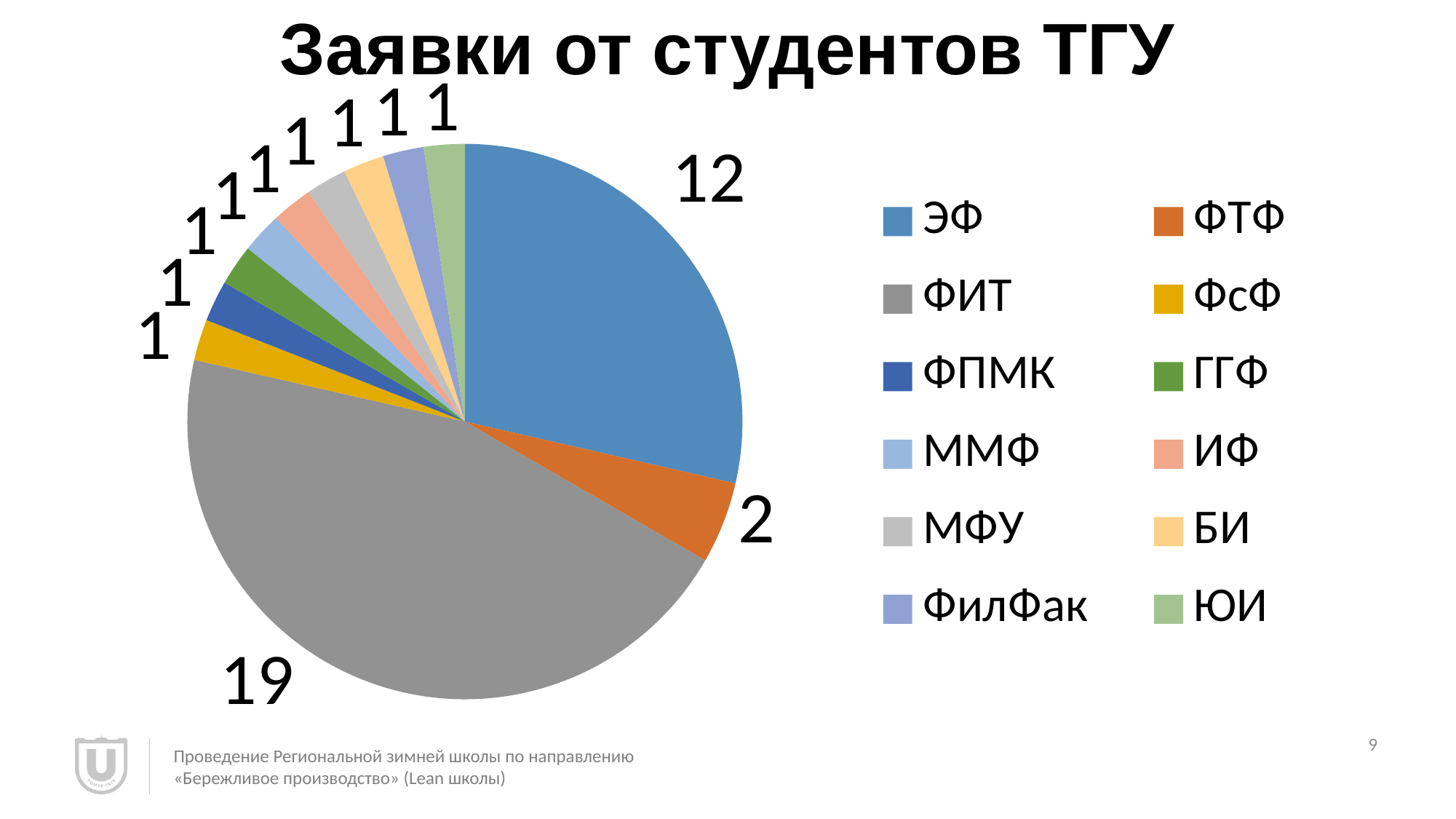
How many applications are shown for ЭФ? 12 Which faculty has the largest slice of the pie? ФИТ How much larger is the value for ЭФ than the value for ФТФ? 10 What value is shown for ФТФ? 2 What is the total of all the values shown on the pie chart? 42 What is the title of the chart? Заявки от студентов ТГУ What value is shown for ГГФ? 1 What is the difference between the values for ФИТ and ЭФ? 7 What value is shown for the ФИТ slice? 19 How many categories does the legend list? 12 Which is larger, the value for ЭФ or the value for ФИТ? ФИТ What kind of chart is shown on the slide? Pie chart